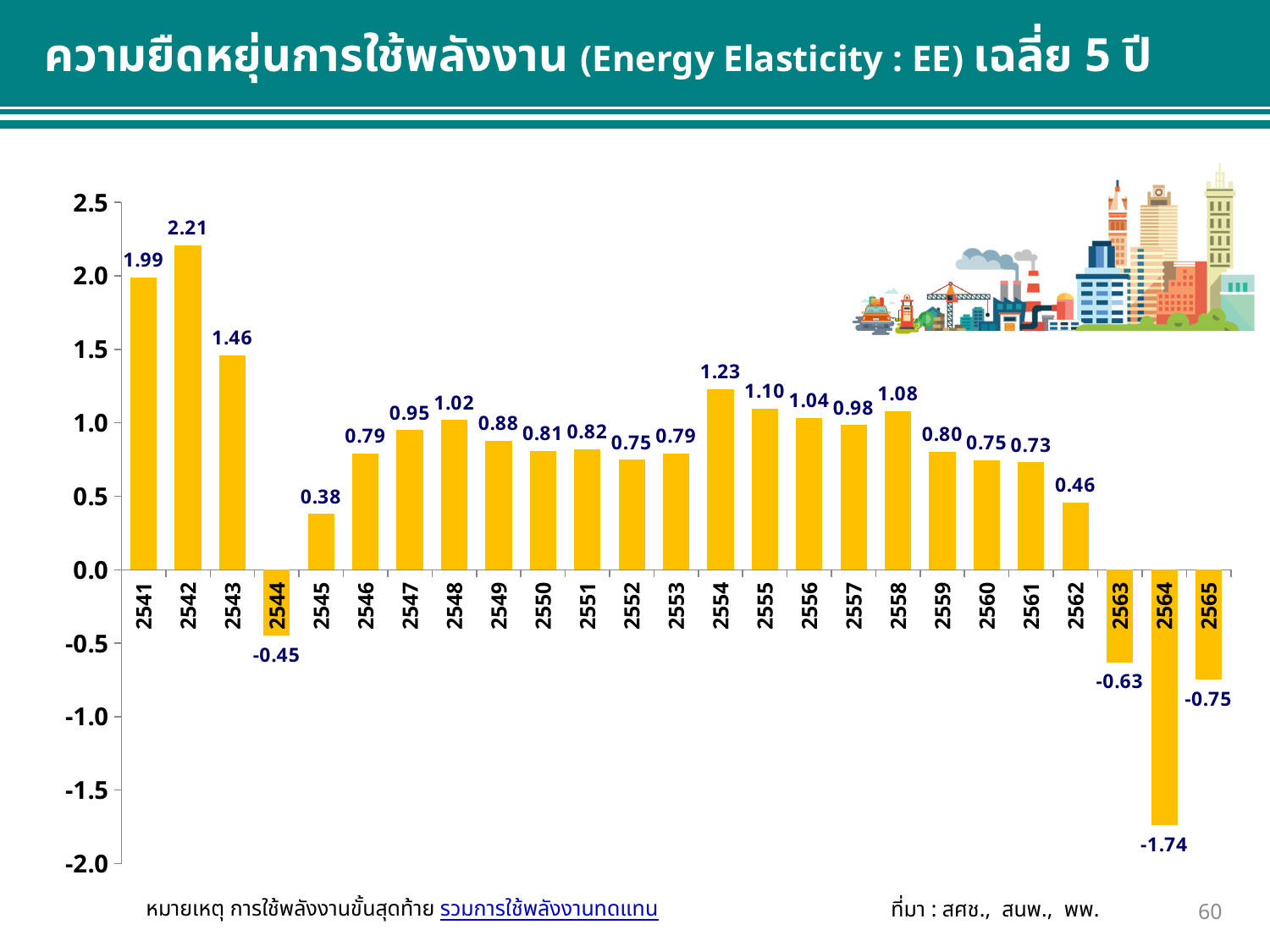
What is the value shown for 2562? 0.46 Which year has the lowest value? 2564 Which year has the highest value? 2542 How many years have a negative value? 4 What is the energy elasticity value for 2542? 2.21 How many years are shown on the x axis? 25 What kind of chart is shown on the slide? bar chart Which is larger, the value for 2555 or the value for 2558? 2555 Is the value for 2548 greater or less than 1.0? greater What is the value shown for 2564? -1.74 What is the value shown for 2554? 1.23 What is the difference between the values for 2541 and 2543? 0.53